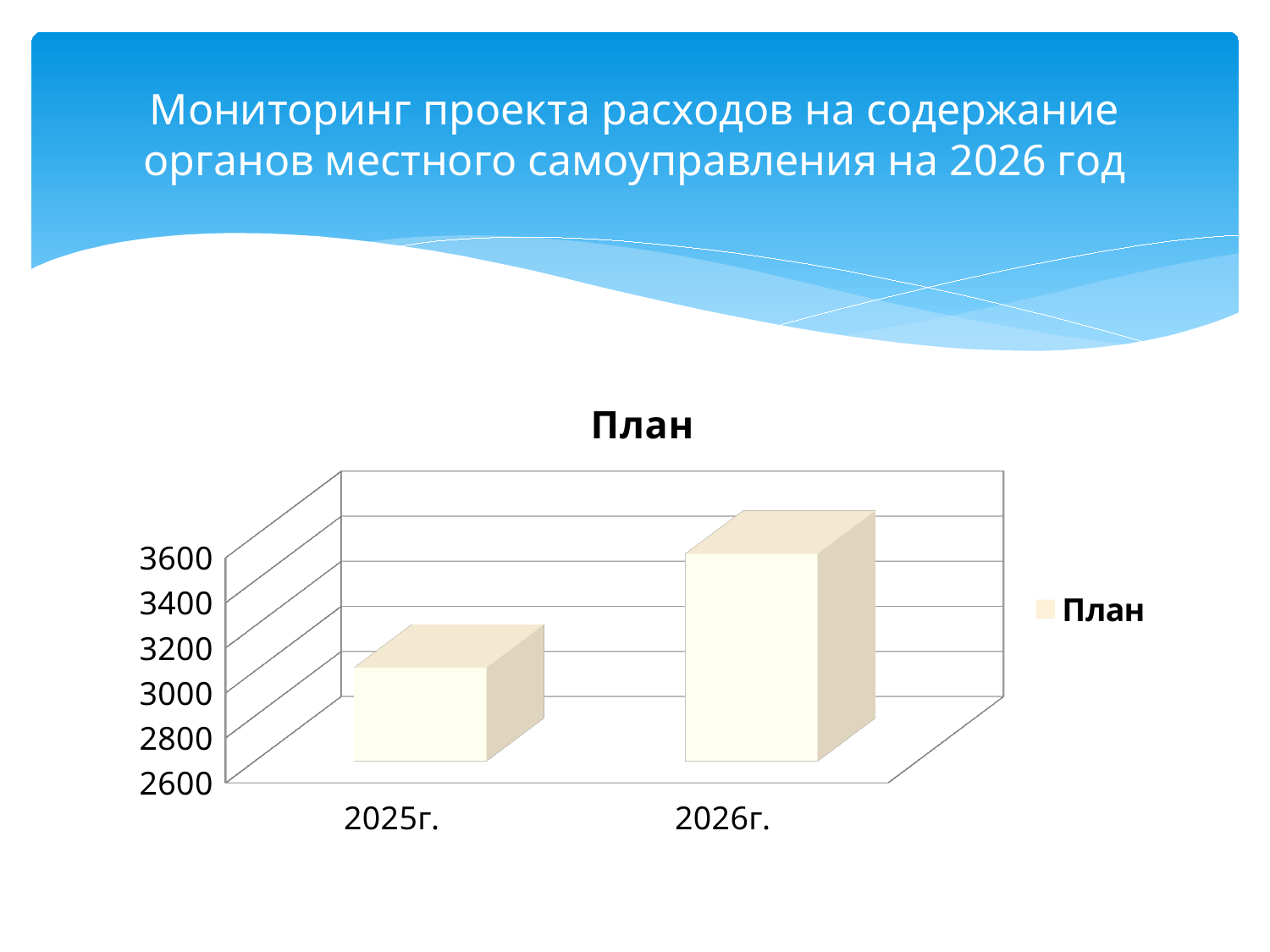
What kind of chart is shown on the slide? bar chart How many categories are shown on the x axis of the chart? 2 Which year has the highest value in the chart? 2026г. How many series does the legend list? 1 Which is larger, the value for 2025г. or the value for 2026г.? 2026г. Do the values rise or fall from 2025г. to 2026г.? rise Which year has the lowest value in the chart? 2025г. Is the value for 2026г. greater or less than 3400? greater Is the value for 2025г. greater or less than 3400? less What is the name of the series listed in the legend? План What is the title of the chart? План